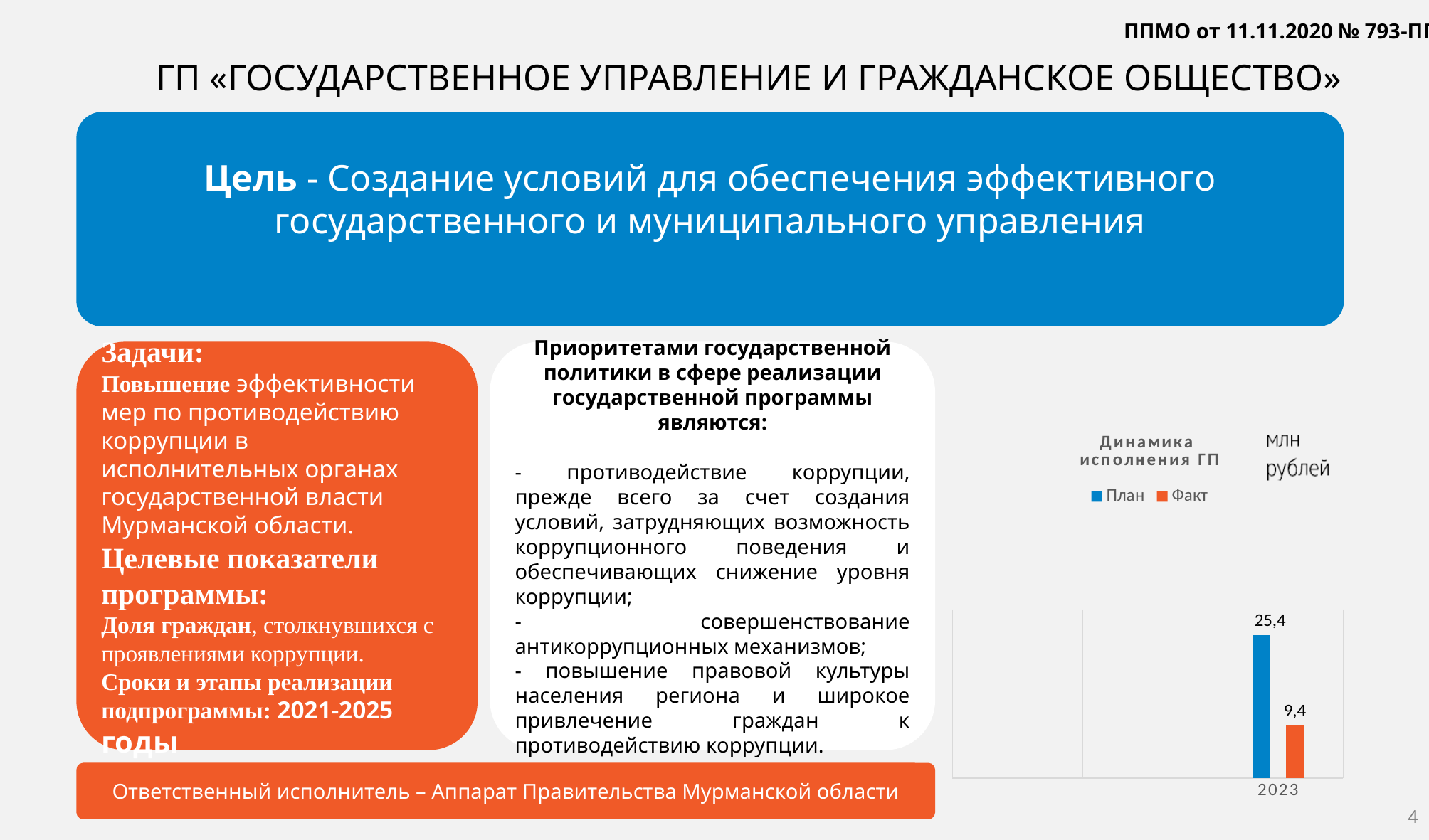
How many categories are shown on the x axis of the chart? 1 What is the value of Факт for 2023 in the chart? 9,4 What unit is indicated next to the chart title? млн рублей What is the difference between План and Факт for 2023? 16,0 How many series does the chart legend list? 2 Which series has the higher value for 2023, План or Факт? План What is the value of План for 2023 in the chart? 25,4 What kind of chart is shown on the slide? bar chart Which year is shown on the x axis of the chart? 2023 What is the title of the chart? Динамика исполнения ГП